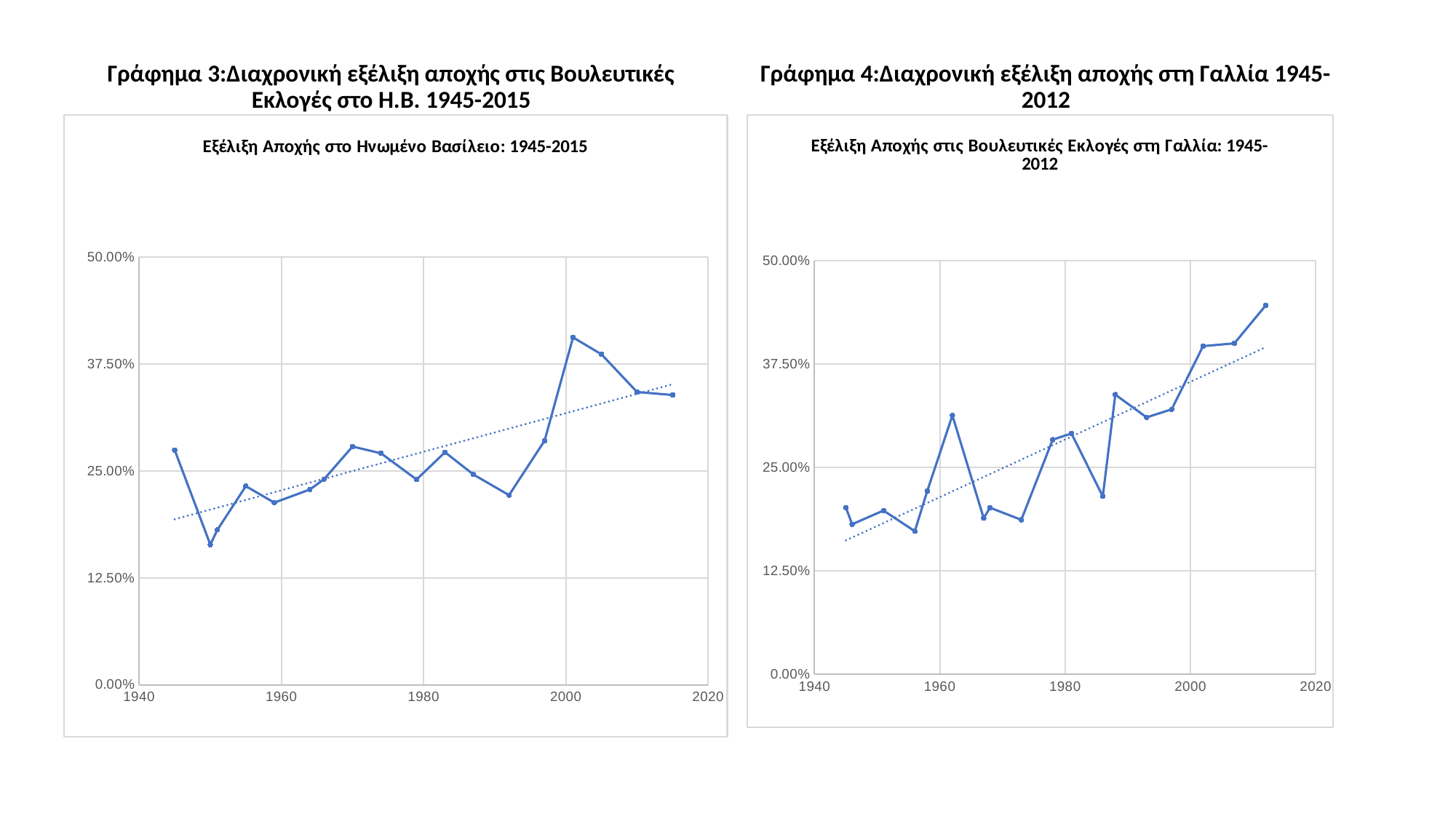
In Γράφημα 3 (the left chart), is the lowest value, around 1950, greater or less than 25.00%? less What is the highest value shown on the y axis of both charts? 50.00% In Γράφημα 4 (the right chart), is the value for the last point (2012) greater or less than 37.50%? greater What kind of chart is Γράφημα 4 (the right chart)? line chart In Γράφημα 3 (the left chart), do the abstention values generally rise or fall from 1945 to 2015? rise In Γράφημα 4 (the right chart), do the abstention values generally rise or fall from 1945 to 2012? rise In Γράφημα 3 (the left chart), is the highest value, reached just after 2000, greater or less than 37.50%? greater In Γράφημα 4 (the right chart), in which year is abstention highest? 2012 What is the inner title printed inside the left chart (Γράφημα 3)? Εξέλιξη Αποχής στο Ηνωμένο Βασίλειο: 1945-2015 What kind of chart is Γράφημα 3 (the left chart)? line chart Which is larger: the highest point in Γράφημα 4 (the right chart, 2012) or the highest point in Γράφημα 3 (the left chart, just after 2000)? Γράφημα 4 (2012)